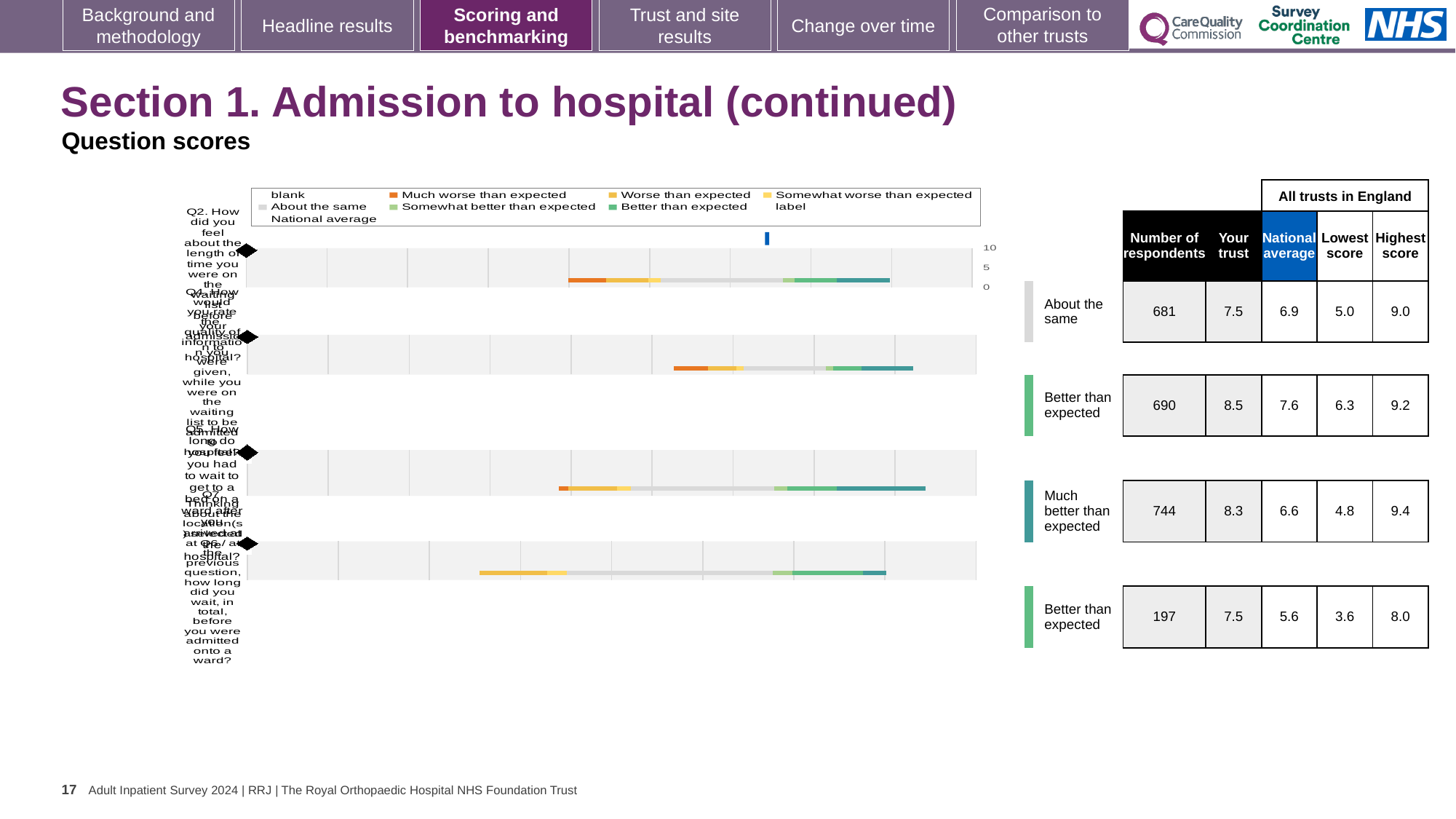
In the table, what is the Highest score for the row labelled 'Much better than expected'? 9.4 How many horizontal bars (question rows) does the chart contain? 4 In the table, what is the Number of respondents for the row labelled 'About the same'? 681 What is the smallest value in the Lowest score column of the table? 3.6 In the table, what is the National average for the row labelled 'About the same'? 6.9 What kind of chart is shown on the slide? bar chart In the table, what is the difference between the Highest score and the Lowest score for the row labelled 'About the same'? 4.0 In the table, what is the 'Your trust' score for the row labelled 'Much better than expected'? 8.3 Which row of the table has the highest Number of respondents? Much better than expected Which has the higher 'Your trust' score in the table: the row labelled 'About the same' or the row labelled 'Much better than expected'? Much better than expected In the table, how much higher is the 'Your trust' score than the National average for the row labelled 'Much better than expected'? 1.7 What heading spans the National average, Lowest score and Highest score columns in the table? All trusts in England